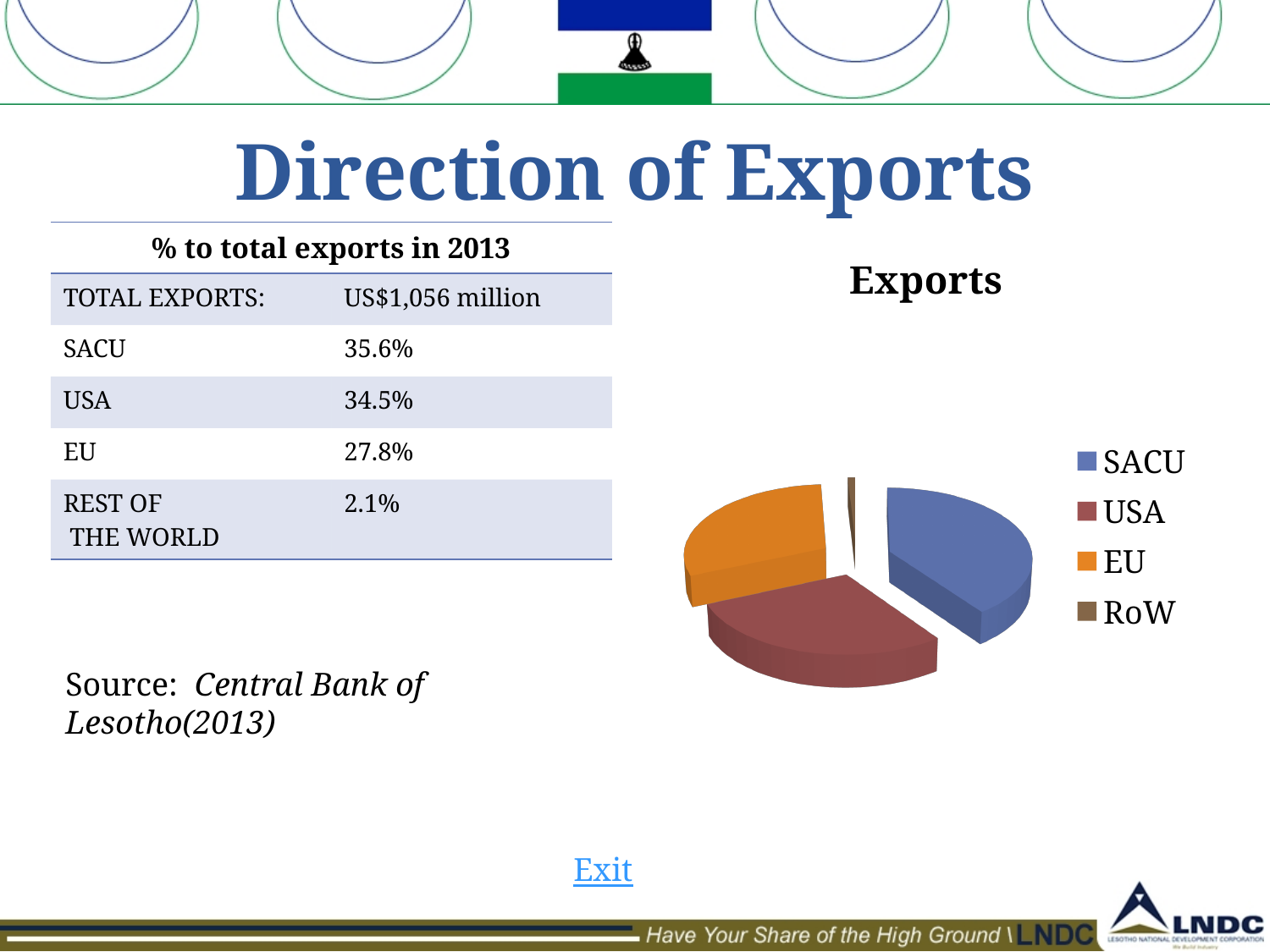
What is the title of the chart? Exports What type of chart is shown on the slide? pie chart What share of total exports in 2013 went to the EU? 27.8% Which category has the smallest slice in the pie chart? RoW What share of total exports in 2013 went to SACU? 35.6% Is the share of exports to the EU larger or smaller than the share to the Rest of the World? larger What share of total exports in 2013 went to the USA? 34.5% Which colour represents the EU in the pie chart? orange What share of total exports in 2013 went to the Rest of the World? 2.1% How many categories does the legend of the pie chart list? 4 What is the difference in percentage points between the EU share and the Rest of the World share of exports? 25.7 Which category has the largest share of exports according to the slide? SACU